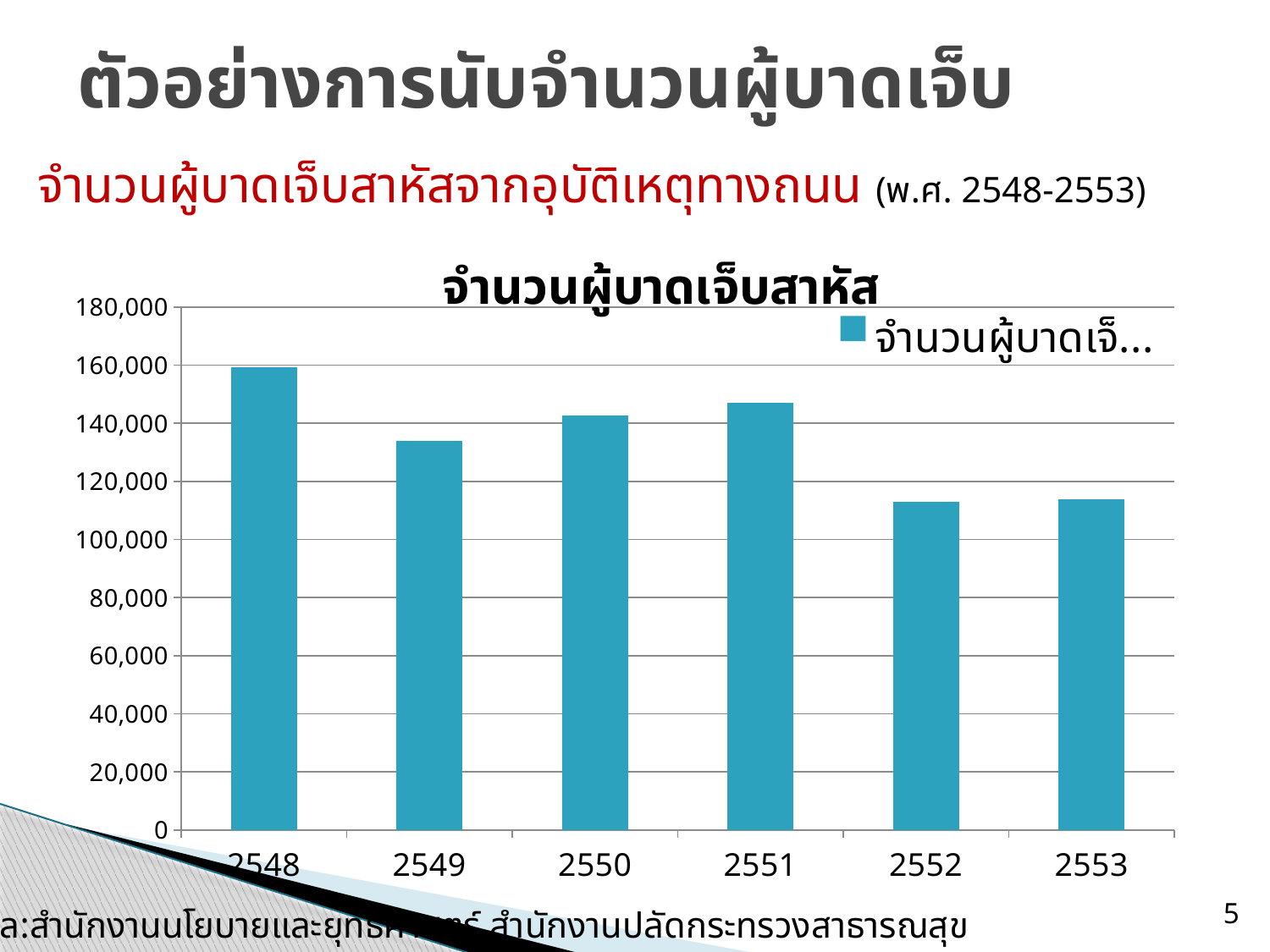
Overall, do the values rise or fall from 2548 to 2553? fall What kind of chart is shown on the slide? bar chart How many series does the legend list? 1 Is the value for 2549 greater or less than 140,000? less How many years (categories) are plotted on the x axis? 6 Is the value for 2552 greater or less than 120,000? less Which year has the larger value, 2548 or 2549? 2548 Which year has the larger value, 2549 or 2550? 2550 Is the value for 2551 greater or less than 140,000? greater Which year has the highest number of seriously injured? 2548 What is the title of the chart? จำนวนผู้บาดเจ็บสาหัส